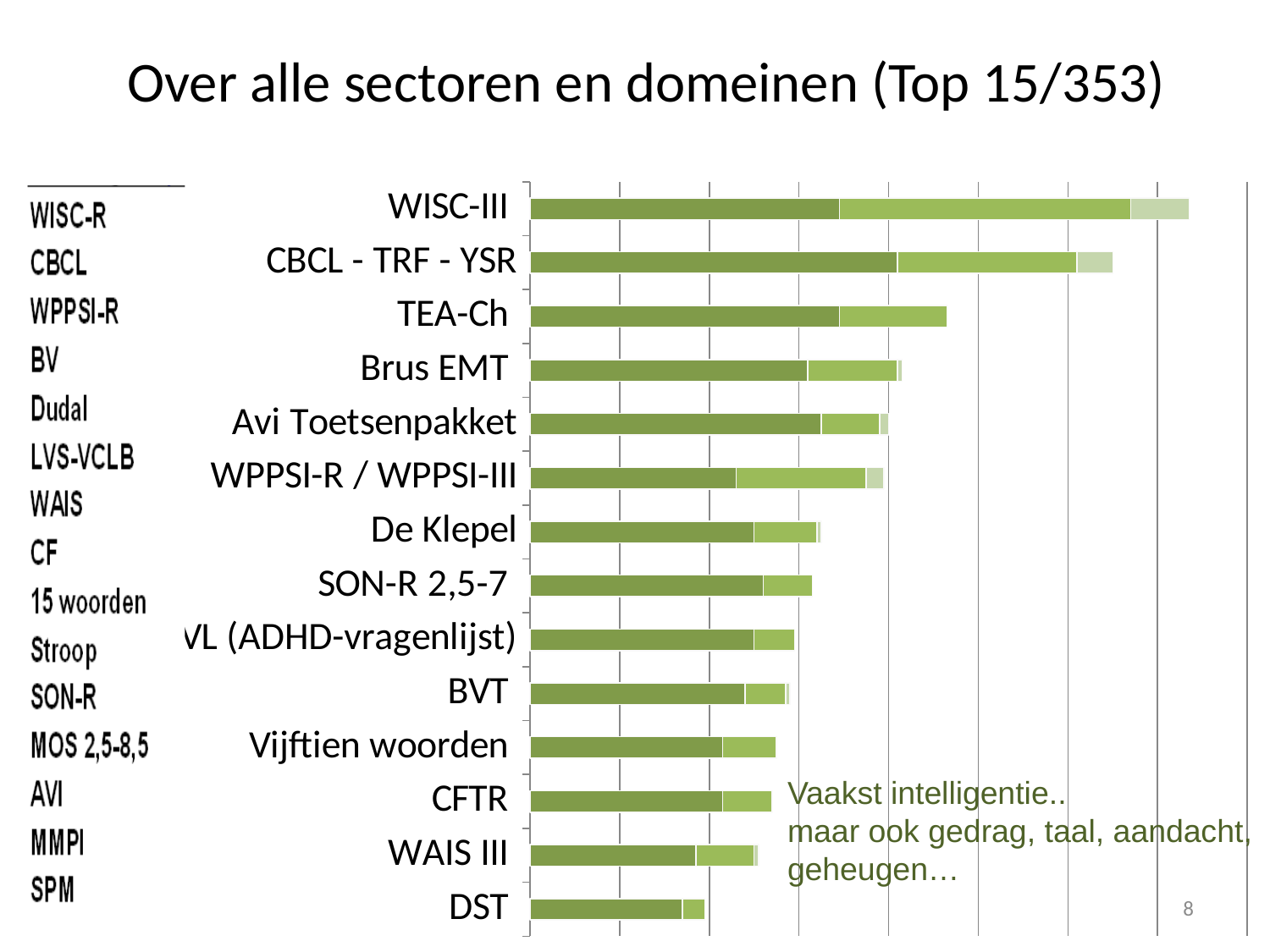
How many categories (bars) are plotted in the chart? 14 Which bar is longer: TEA-Ch or Brus EMT? TEA-Ch What colour are the bars in the chart? Green Do the bar lengths increase or decrease going from the top of the chart to the bottom? Decrease Which bar is longer: Vijftien woorden or Avi Toetsenpakket? Avi Toetsenpakket Which bar is longer: De Klepel or WAIS III? De Klepel What kind of chart is shown on the slide? Bar chart Which category has the longest bar in the chart? WISC-III Which category is listed directly below TEA-Ch in the chart? Brus EMT What is the title of the slide containing the chart? Over alle sectoren en domeinen (Top 15/353) Which category has the shortest bar in the chart? DST